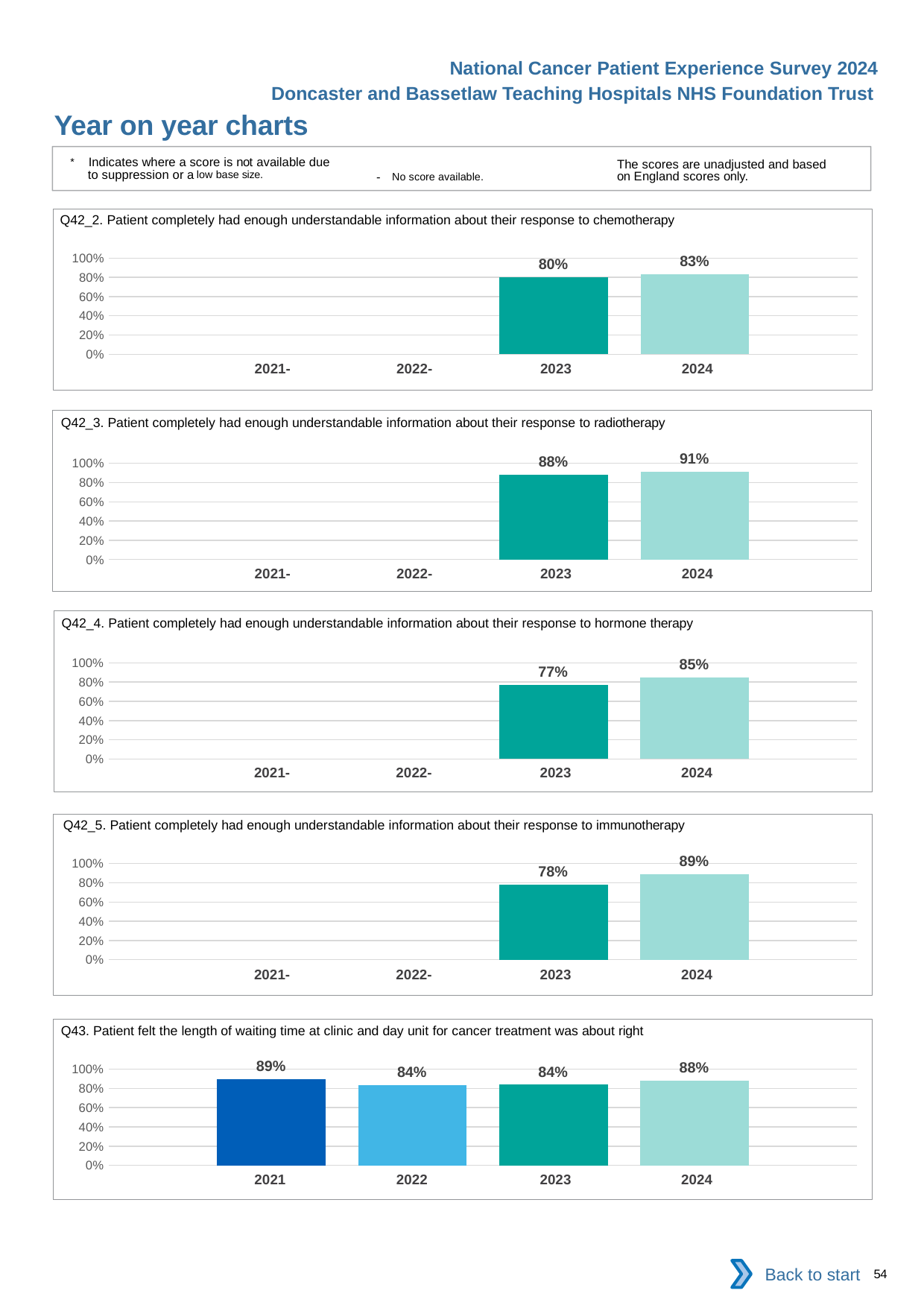
In the Q42_5 chart (immunotherapy), what is the difference between the 2024 and 2023 values? 11 percentage points In the Q42_2 chart (chemotherapy), how many years have a bar plotted? 2 In the Q43 chart (waiting time at clinic and day unit), which year has the highest value? 2021 In the Q42_4 chart (hormone therapy), what is the difference between the 2024 and 2023 values? 8 percentage points What type of chart is the Q43 chart? Bar chart How many charts are shown on the slide? 5 In the Q42_3 chart (radiotherapy), is the value for 2024 greater or less than 80%? greater In the Q43 chart (waiting time at clinic and day unit), what is the value for 2022? 84% In the Q42_5 chart (immunotherapy), which year has the higher value, 2023 or 2024? 2024 In the Q43 chart (waiting time at clinic and day unit), how many bars are plotted? 4 In the Q42_3 chart (radiotherapy), what is the value for 2023? 88% In the Q42_2 chart (chemotherapy), what is the value for 2024? 83%